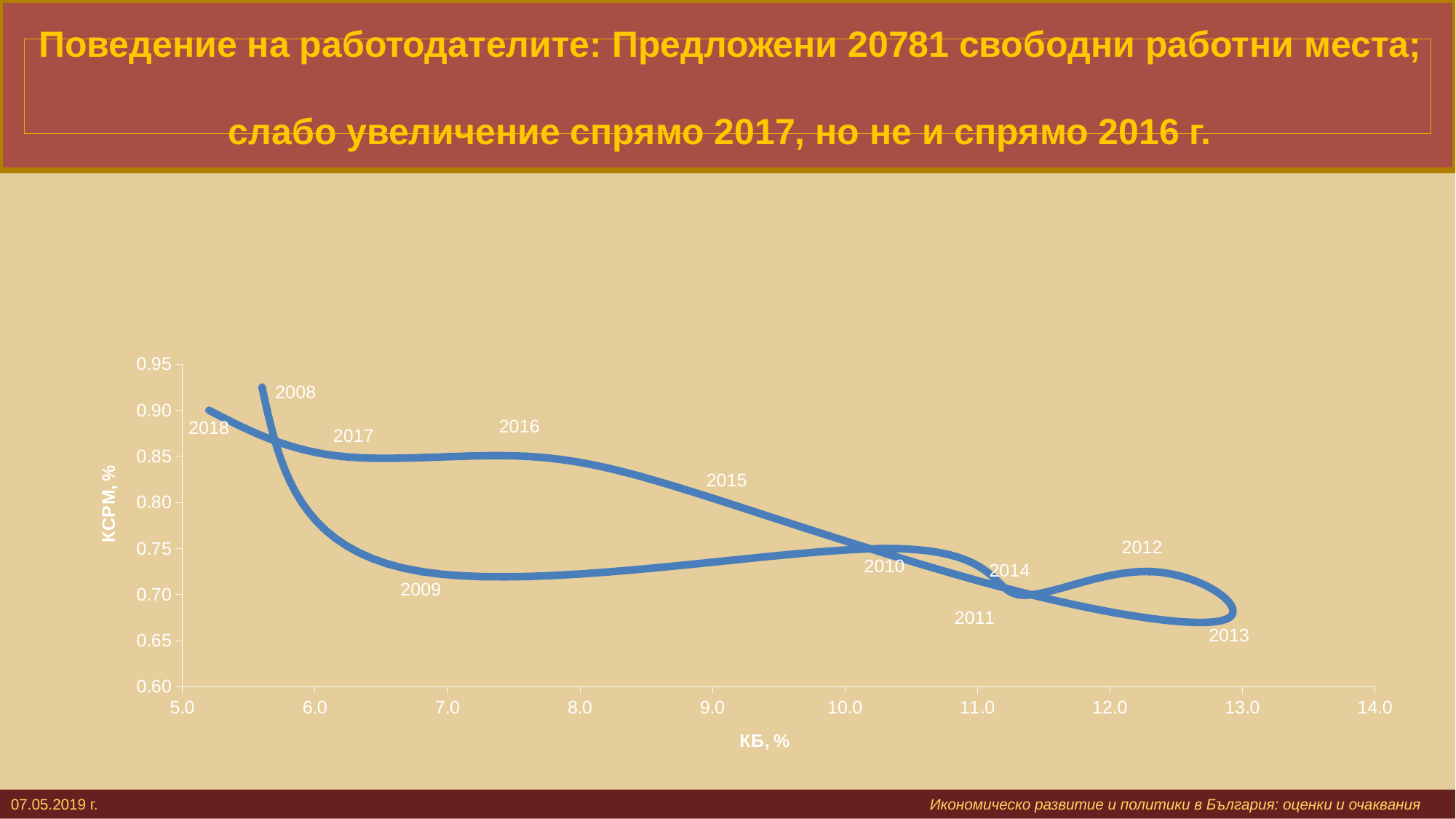
Which year has the lowest КСРМ value? 2013 Which year has the highest КСРМ value? 2008 How many year-labelled points are plotted on the chart? 11 What is the label of the horizontal axis? КБ, % Which year has the larger КСРМ value, 2016 or 2015? 2016 Is the КБ value for 2013 greater or less than 12.0? greater Which year has the lowest КБ value? 2018 What is the label of the vertical axis? КСРМ, % Is the КСРМ value for 2008 greater or less than 0.90? greater Which year has the larger КБ value, 2013 or 2018? 2013 What kind of chart is shown on the slide? line chart Is the КСРМ value for 2009 greater or less than 0.75? less